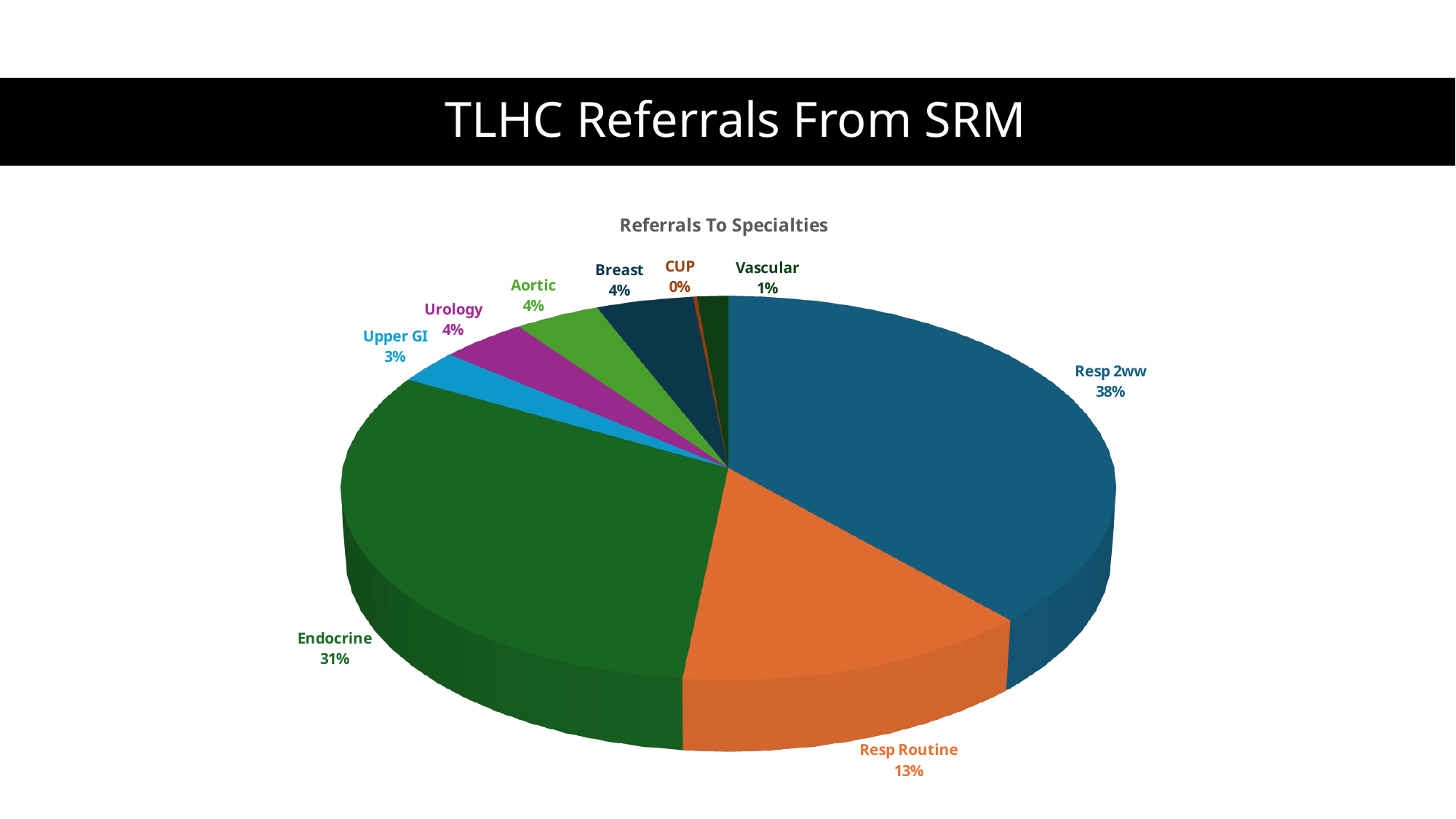
What is the title of the chart? Referrals To Specialties What share of referrals went to Resp 2ww? 38% How many specialties are shown in the pie chart? 9 What share of referrals went to Upper GI? 3% Which specialty received the largest share of referrals? Resp 2ww Which specialty received the smallest share of referrals? CUP What share of referrals went to Resp Routine? 13% What type of chart is shown on the slide? Pie chart Which is larger, the share for Resp Routine or the share for Breast? Resp Routine What share of referrals went to Endocrine? 31% What is the difference in percentage points between Resp 2ww and Endocrine? 7 What share of referrals went to Vascular? 1%